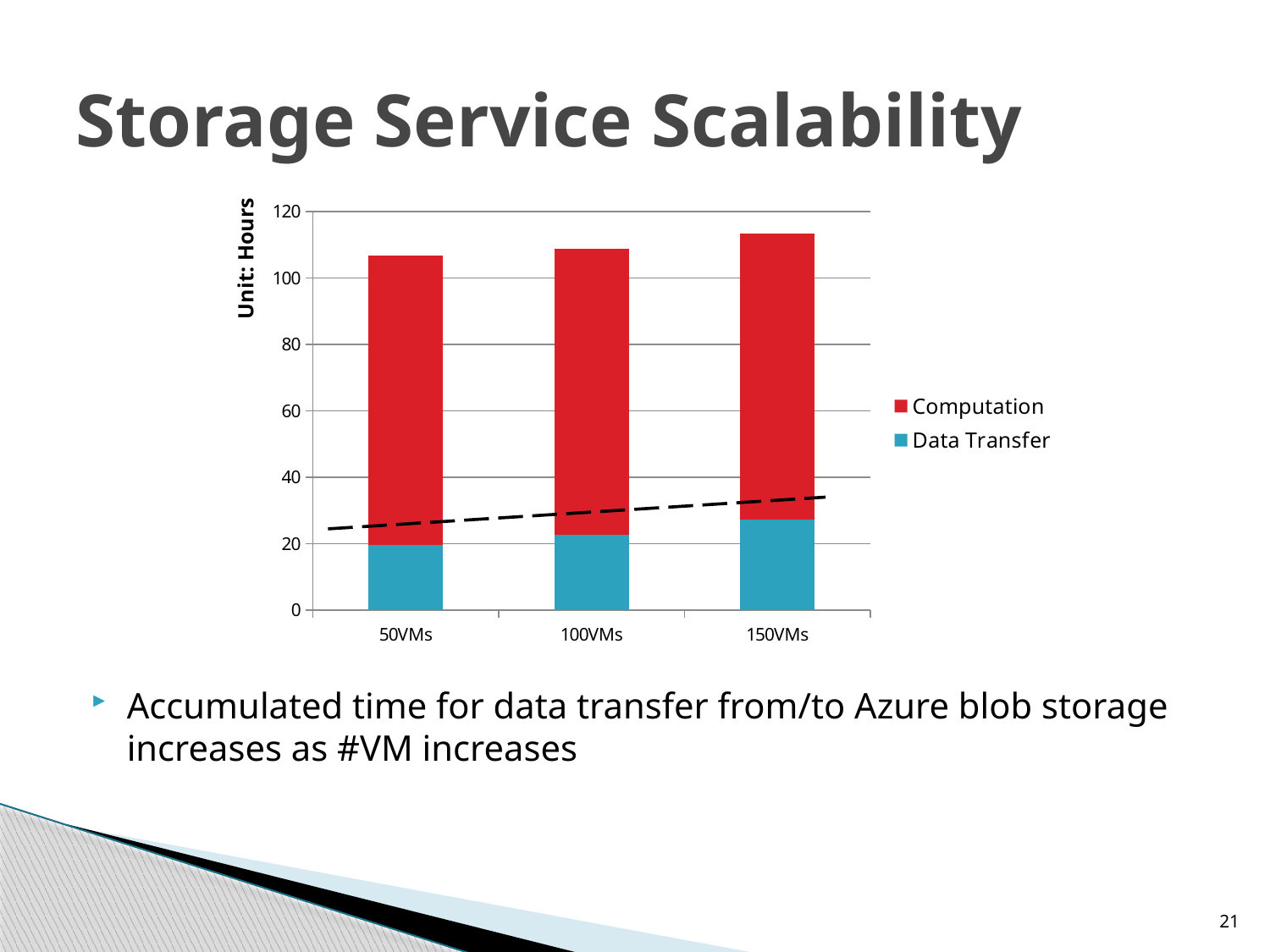
Do the Data Transfer values rise or fall as the number of VMs increases along the x axis? Rise Which category has the lowest Data Transfer value? 50VMs Is the total bar height for 50VMs greater or less than 100? greater What kind of chart is shown on the slide? Stacked bar chart Which colour represents the Computation series in the chart? Red Which category has the highest total bar height? 150VMs What is the label on the vertical axis of the chart? Unit: Hours Is the total bar height for 150VMs greater or less than 120? less How many categories are shown on the x axis of the chart? 3 How many series does the chart's legend list? 2 Is the Data Transfer value for 150VMs greater or less than 20? greater Which is larger, the Data Transfer value for 150VMs or for 50VMs? 150VMs